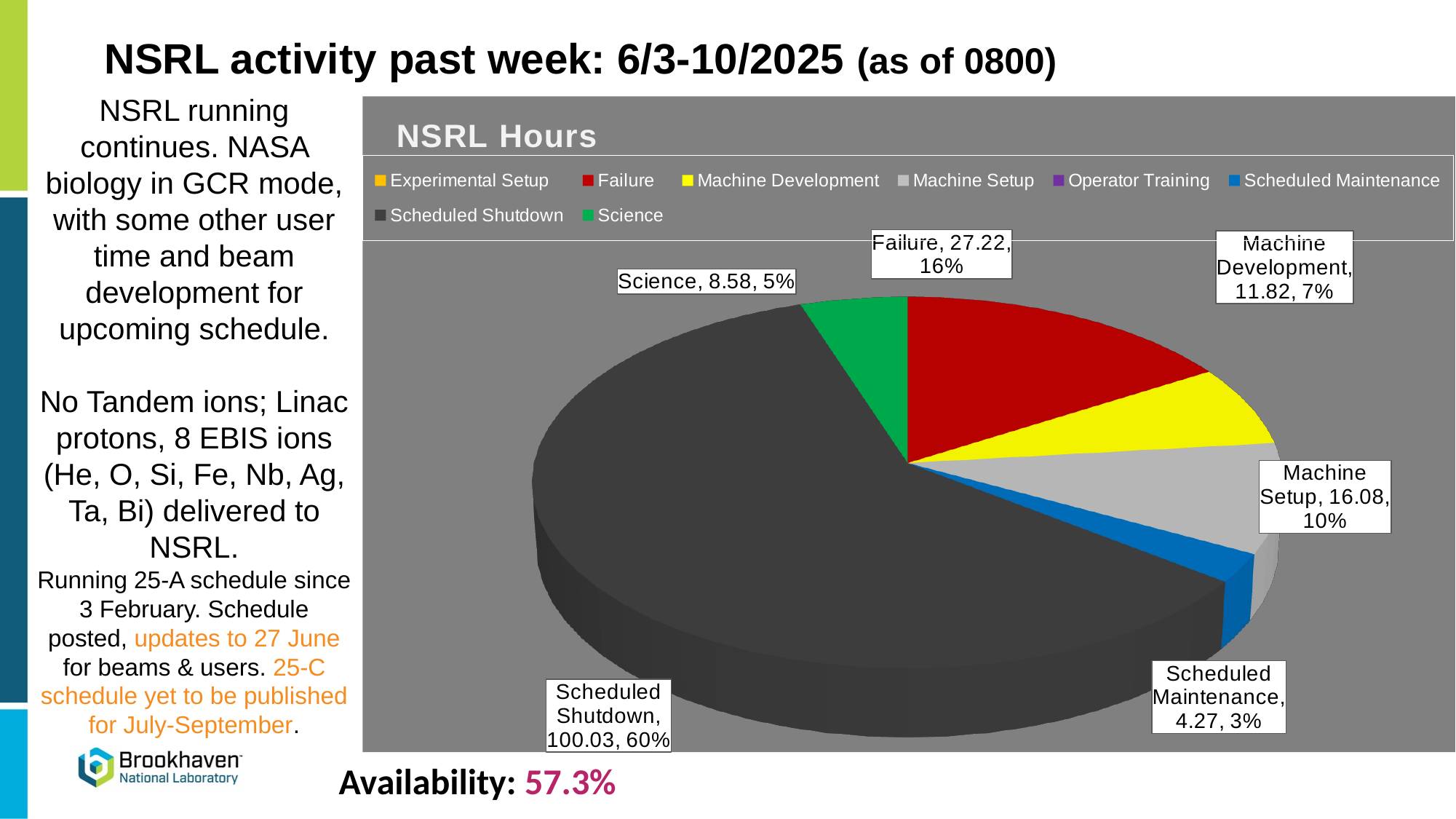
How many hours are shown for Machine Setup? 16.08 What percentage share of the pie does Machine Development have? 7% What percentage share of the pie does Science have? 5% How many hours are shown for Scheduled Shutdown? 100.03 Which category has the largest slice of the pie? Scheduled Shutdown What is the difference in hours between Failure and Machine Setup? 11.14 What is the title of the chart? NSRL Hours What type of chart is shown on the slide? Pie chart How many hours are shown for Failure? 27.22 Which labeled category has the smallest slice of the pie? Scheduled Maintenance How many entries does the chart legend list? 8 Which has more hours, Machine Development or Science? Machine Development